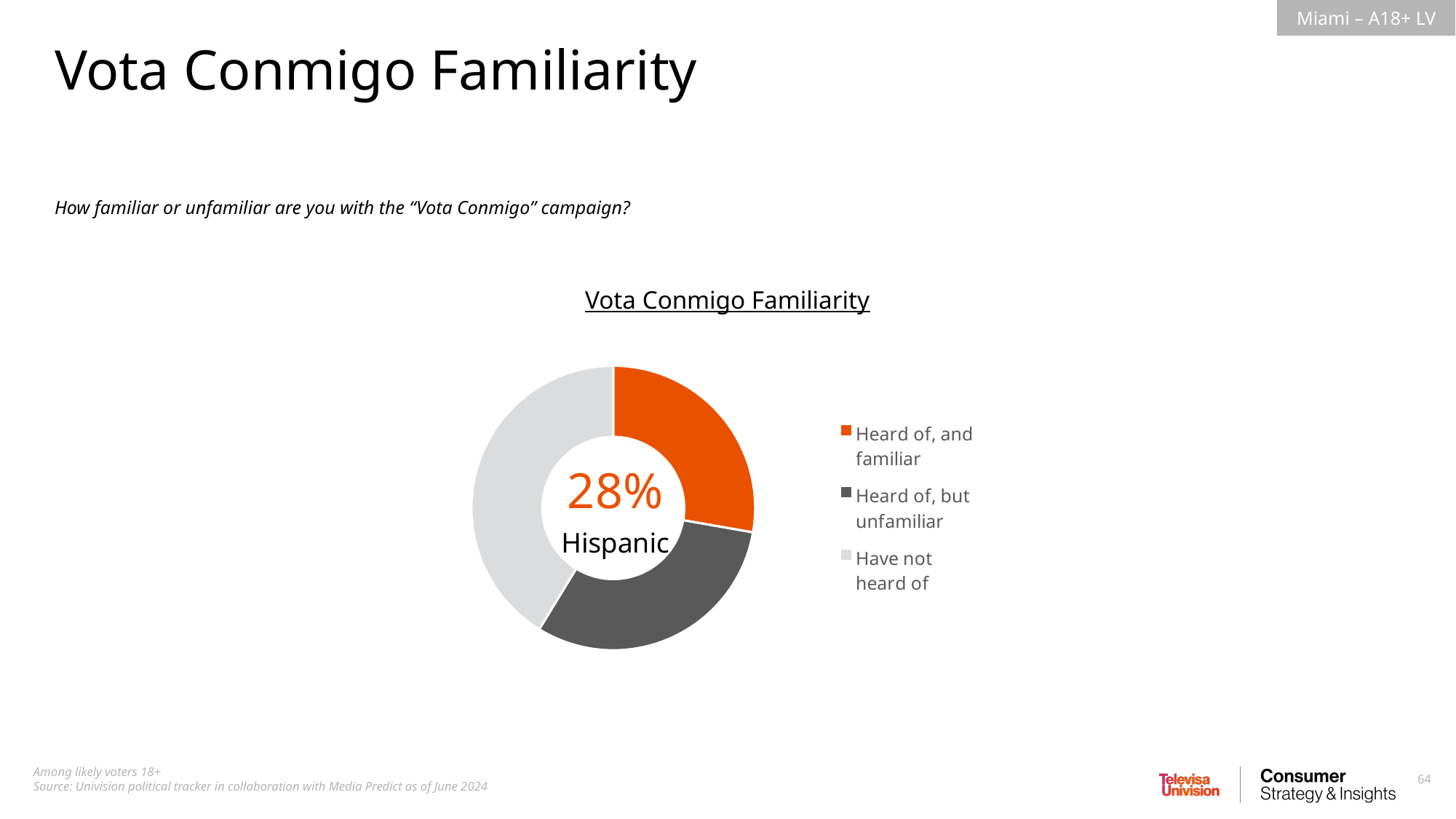
What is the title of the chart? Vota Conmigo Familiarity What share of Hispanic likely voters have heard of and are familiar with the Vota Conmigo campaign? 28% Which category takes up the largest slice of the donut chart? Have not heard of Which colour represents 'Heard of, and familiar' in the chart? orange How many slices does the donut chart have? 3 What kind of chart is shown on the slide? donut (pie) chart What percentage is printed in the centre of the donut chart? 28% How many entries does the legend list? 3 Which group is named in the centre of the donut chart? Hispanic Which slice is larger: 'Have not heard of' or 'Heard of, and familiar'? Have not heard of